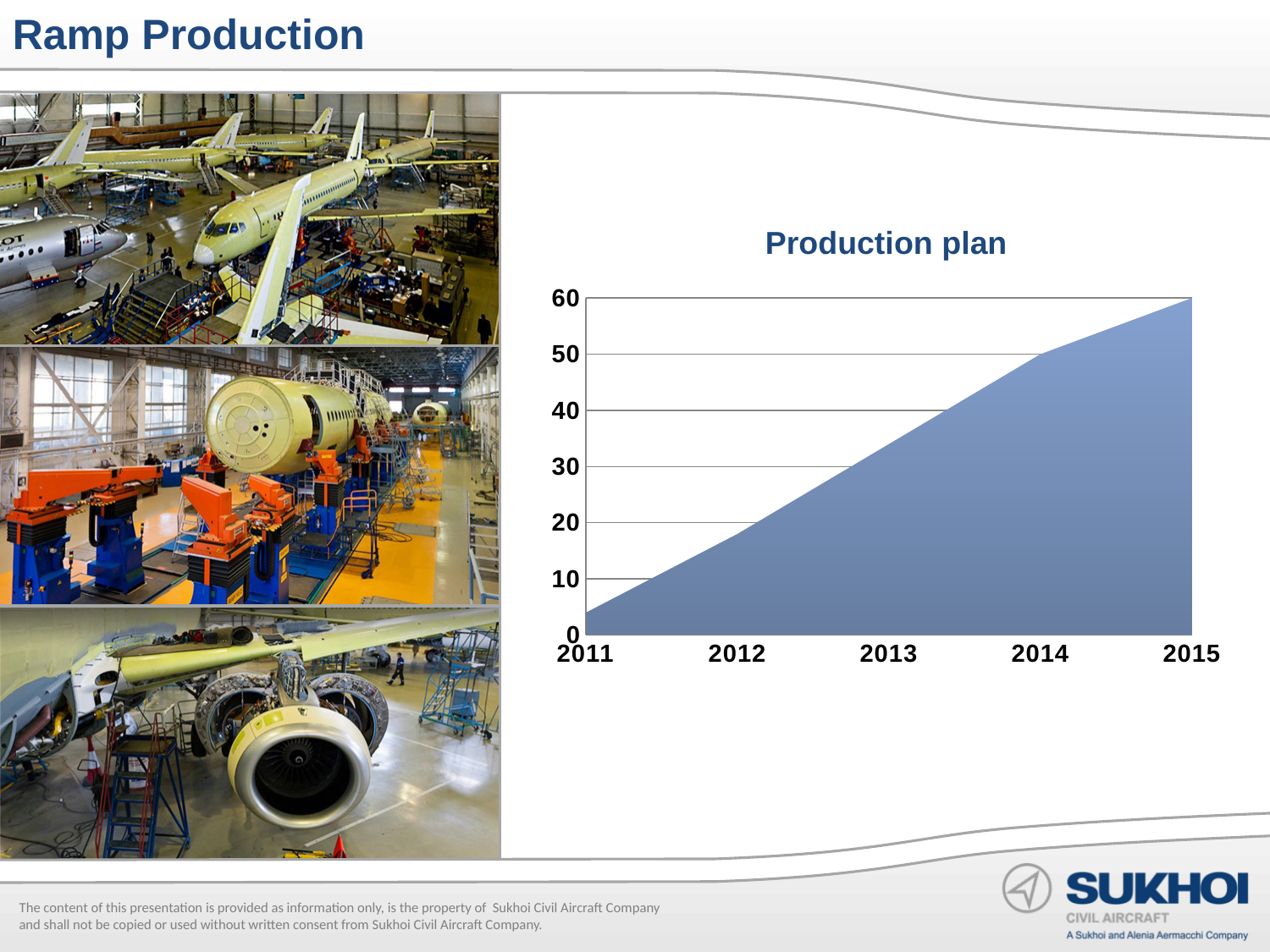
Is the value for 2014 in the Production plan chart greater or less than 40? greater Do the values in the Production plan chart rise or fall from 2011 to 2015? rise What is the value for 2015 in the Production plan chart? 60 Is the value for 2013 in the Production plan chart greater or less than 30? greater What is the title of the chart on the slide? Production plan Which year has the lowest value in the Production plan chart? 2011 Which year has the highest value in the Production plan chart? 2015 Is the value for 2011 in the Production plan chart greater or less than 10? less How many years are shown on the x axis of the Production plan chart? 5 What kind of chart is the Production plan chart? area chart In the Production plan chart, which year has the larger value, 2012 or 2014? 2014